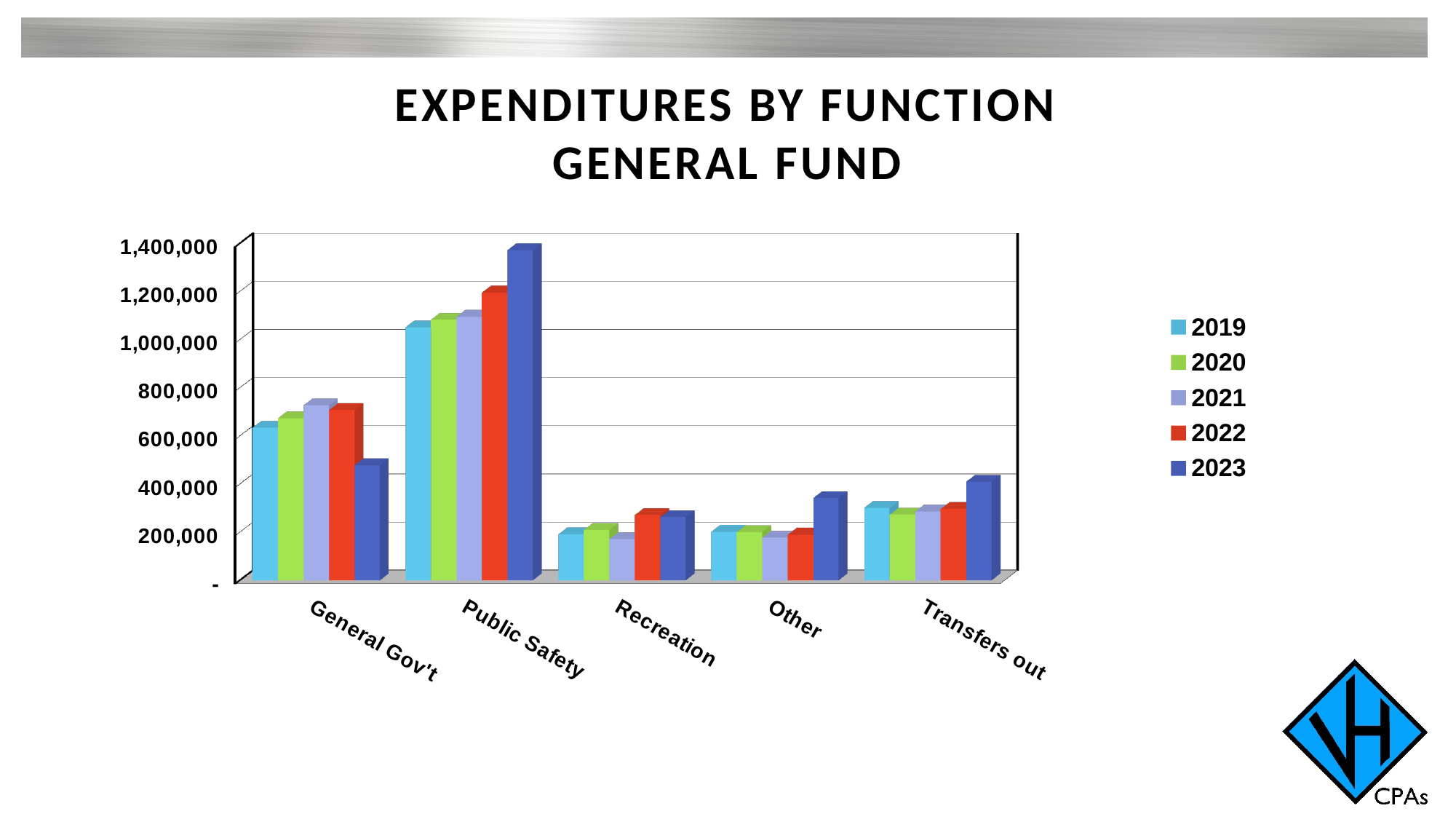
How many series does the legend list? 5 Which category has the lowest expenditures in 2023? Recreation What is the title of the chart? EXPENDITURES BY FUNCTION GENERAL FUND Is the value for General Gov't in 2023 greater or less than 600,000? less What kind of chart is shown on the slide? bar chart Is the value for Recreation in 2022 greater or less than 200,000? greater Which category has the highest expenditures in 2023? Public Safety Is the value for Public Safety in 2023 greater or less than 1,200,000? greater Do the Public Safety expenditures rise or fall from 2019 to 2023? rise For General Gov't, which is larger: the 2022 value or the 2023 value? 2022 How many categories are shown on the x axis of the chart? 5